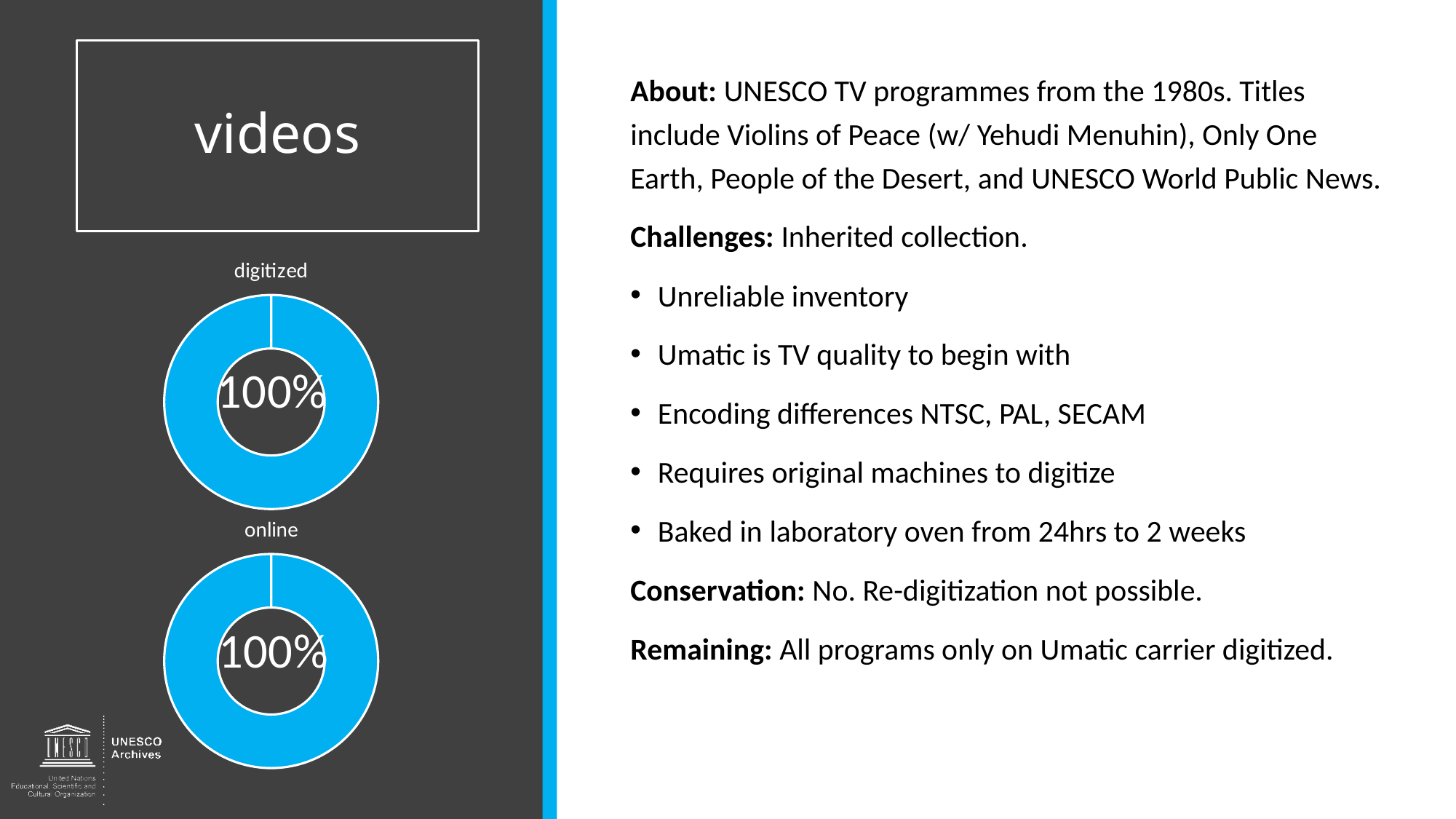
How many charts are shown on the slide? 2 In the 'digitized' chart, what value is shown in the centre of the doughnut? 100% Is the value shown in the 'digitized' chart the same as the value shown in the 'online' chart? Yes What is the title of the top chart on the slide? digitized In the 'digitized' chart, what share of the doughnut is filled? 100% In the 'online' chart, what share of the doughnut is filled? 100% What kind of chart is the 'online' chart? doughnut chart How many visible slices make up the 'digitized' doughnut chart? 1 In the 'online' chart, what value is shown in the centre of the doughnut? 100% What is the title of the bottom chart on the slide? online What kind of chart is the 'digitized' chart? doughnut chart